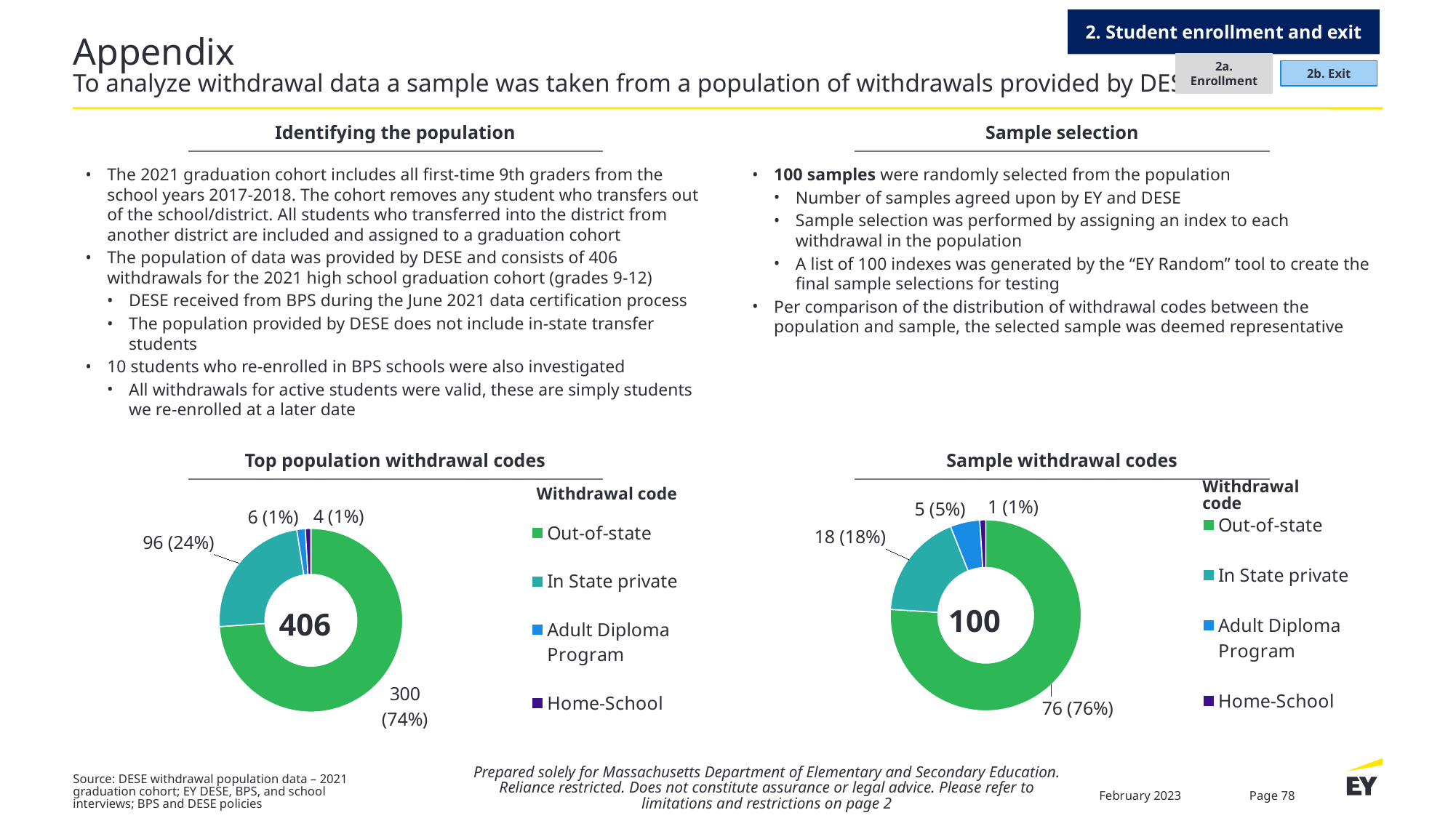
In the 'Sample withdrawal codes' chart, what is the difference between the Out-of-state count and the In State private count? 58 How many withdrawal codes does the legend of the 'Sample withdrawal codes' chart list? 4 In the 'Top population withdrawal codes' chart, which withdrawal code has the smallest count? Home-School In the 'Top population withdrawal codes' chart, what is the total number shown in the centre of the donut? 406 In the 'Top population withdrawal codes' chart, which withdrawal code has the largest share? Out-of-state In the 'Top population withdrawal codes' chart, how many withdrawals are Out-of-state? 300 (74%) In the 'Sample withdrawal codes' chart, what is the value for Out-of-state? 76 (76%) In the 'Top population withdrawal codes' chart, what is the value for In State private? 96 (24%) In the 'Sample withdrawal codes' chart, what is the value for Home-School? 1 (1%) In the 'Top population withdrawal codes' chart, what is the value for Adult Diploma Program? 6 (1%) What type of chart is used for 'Top population withdrawal codes'? Donut (pie) chart In the 'Sample withdrawal codes' chart, what is the value for In State private? 18 (18%)